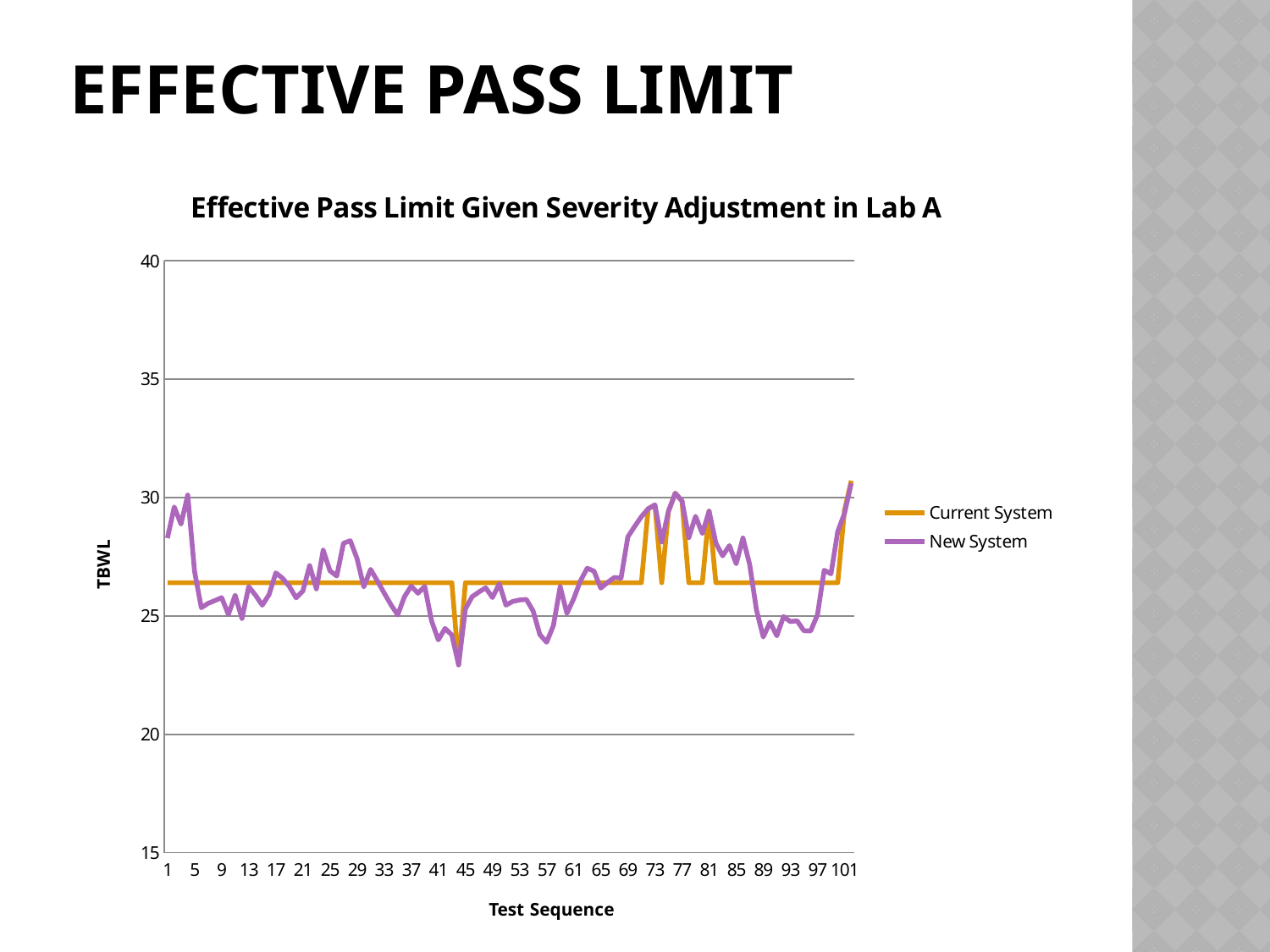
Is the value for the New System at test sequence 57 greater or less than 25? less Is the value for the New System at test sequence 1 greater or less than 25? greater How many series does the legend list? 2 What is the title of the chart? Effective Pass Limit Given Severity Adjustment in Lab A Is the value for the New System at test sequence 89 greater or less than 25? less What is the label of the vertical axis? TBWL At test sequence 89, which series has the higher value, Current System or New System? Current System What kind of chart is shown on the slide? line chart At test sequence 1, which series has the higher value, Current System or New System? New System